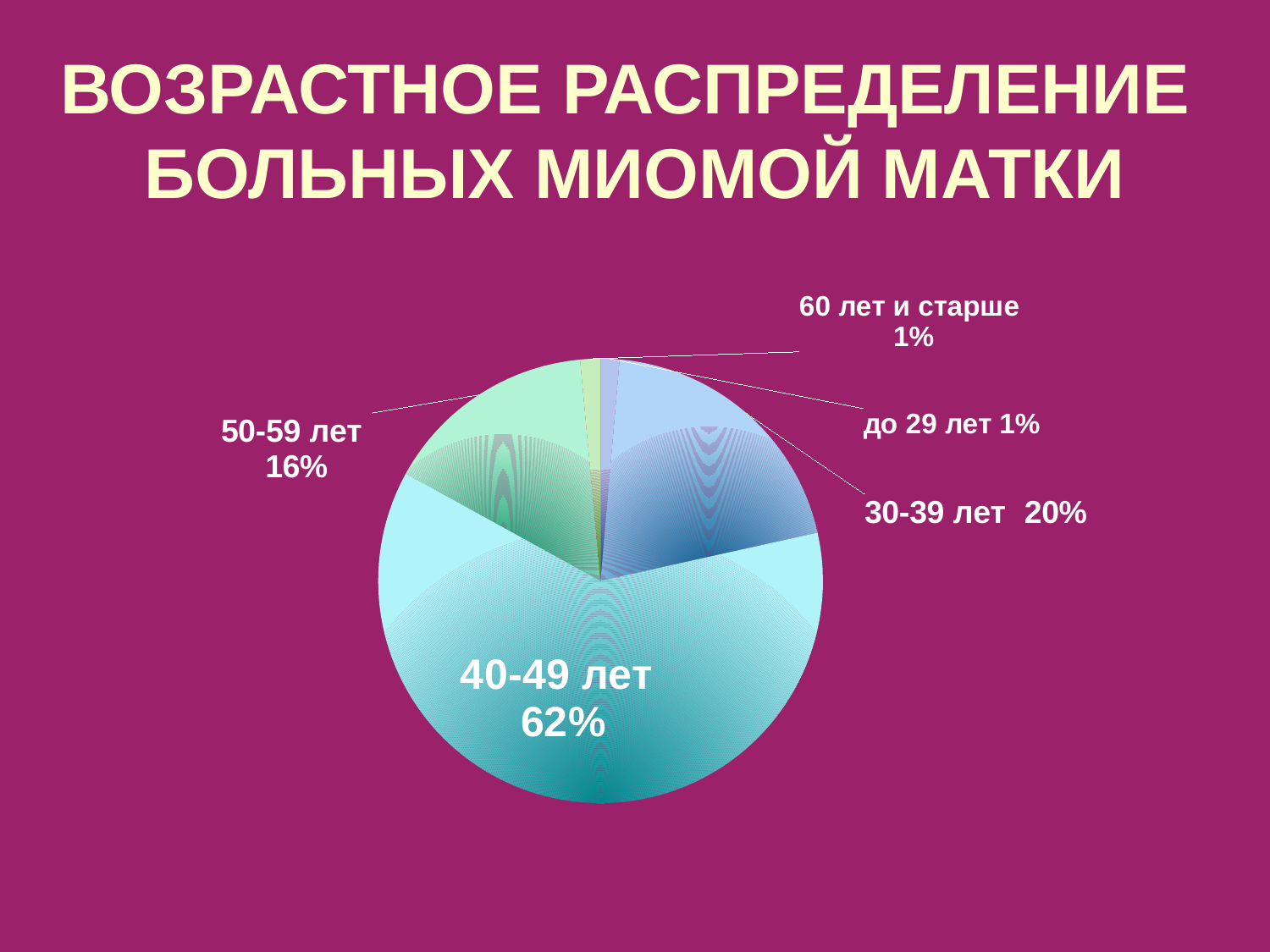
What share of patients are in the 40-49 лет age group? 62% How many age groups are shown in the pie chart? 5 What kind of chart is shown on the slide? Pie chart What share of patients are aged до 29 лет? 1% What share of patients are in the 50-59 лет age group? 16% Which age group has the largest share of patients? 40-49 лет What is the difference in percentage points between the 30-39 лет and 50-59 лет groups? 4 What is the title of the slide? ВОЗРАСТНОЕ РАСПРЕДЕЛЕНИЕ БОЛЬНЫХ МИОМОЙ МАТКИ Which group has a larger share, 30-39 лет or 50-59 лет? 30-39 лет What share of patients are in the 30-39 лет age group? 20% What share of patients are aged 60 лет и старше? 1% What is the difference in percentage points between the 40-49 лет and 30-39 лет groups? 42